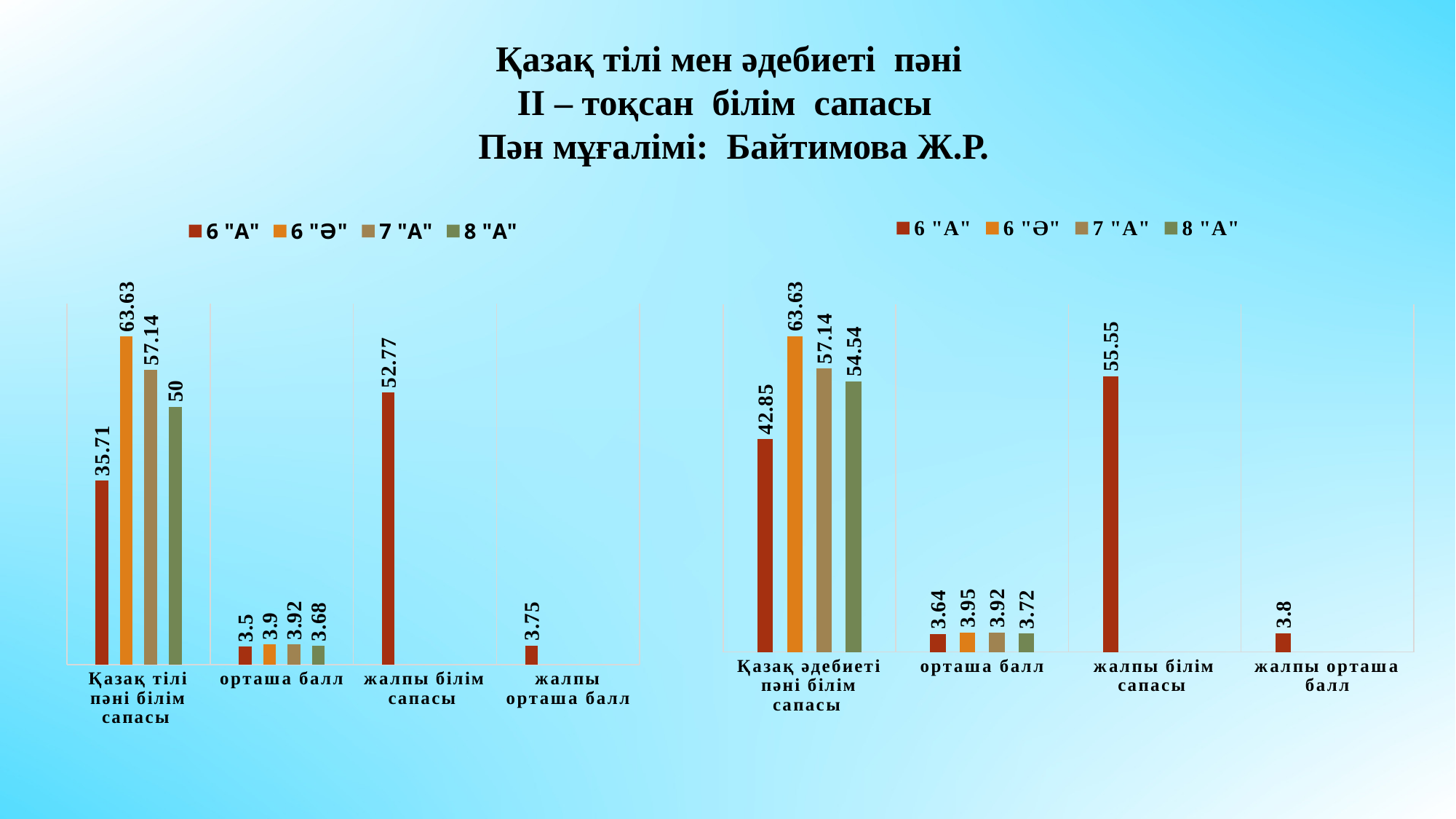
In the right chart, what is the value shown for жалпы орташа балл? 3.8 What type of chart is the left chart? Bar chart In the left chart, which class has the highest value in the category Қазақ тілі пәні білім сапасы? 6 "Ә" In the right chart, which is larger: the 6 "Ә" value or the 7 "А" value in the category орташа балл? 6 "Ә" In the right chart, what is the value for 8 "А" in the category Қазақ әдебиеті пәні білім сапасы? 54.54 How many series does the legend of the right chart list? 4 In the left chart, which class has the lowest value in the category орташа балл? 6 "А" In the left chart, what is the difference between the 6 "Ә" and 6 "А" values in the category Қазақ тілі пәні білім сапасы? 27.92 In the left chart, what is the value for 8 "А" in the category Қазақ тілі пәні білім сапасы? 50 In the right chart, which class has the lowest value in the category Қазақ әдебиеті пәні білім сапасы? 6 "А" In the left chart, what is the value for 6 "Ә" in the category Қазақ тілі пәні білім сапасы? 63.63 In the left chart, what is the value shown for жалпы білім сапасы? 52.77